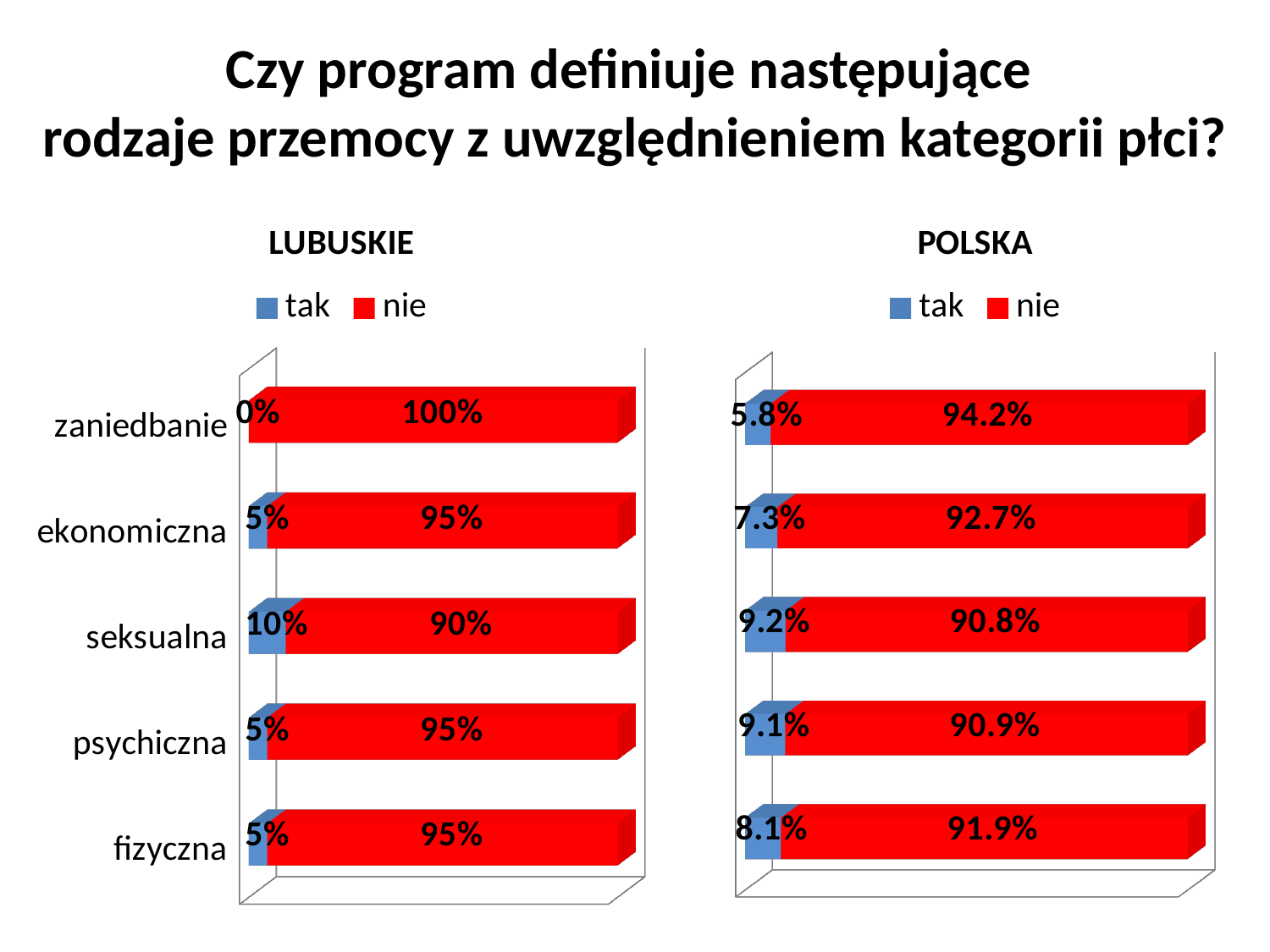
In the LUBUSKIE chart, what is the difference between the "tak" values for seksualna and ekonomiczna? 5% Is the "tak" value for ekonomiczna larger in the LUBUSKIE chart or the POLSKA chart? POLSKA In the POLSKA chart, what is the value of "nie" for zaniedbanie? 94.2% In the POLSKA chart, what is the value of "tak" for fizyczna? 8.1% How many series does the legend of the LUBUSKIE chart list? 2 In the LUBUSKIE chart, which category has the highest "tak" value? seksualna In the POLSKA chart, what is the difference between the "nie" values for zaniedbanie and seksualna? 3.4% In the POLSKA chart, which category has the lowest "tak" value? zaniedbanie In the POLSKA chart, which category has the highest "tak" value? seksualna In the LUBUSKIE chart, what is the value of "tak" for seksualna? 10% How many categories are shown in the POLSKA chart? 5 In the LUBUSKIE chart, what is the value of "nie" for zaniedbanie? 100%